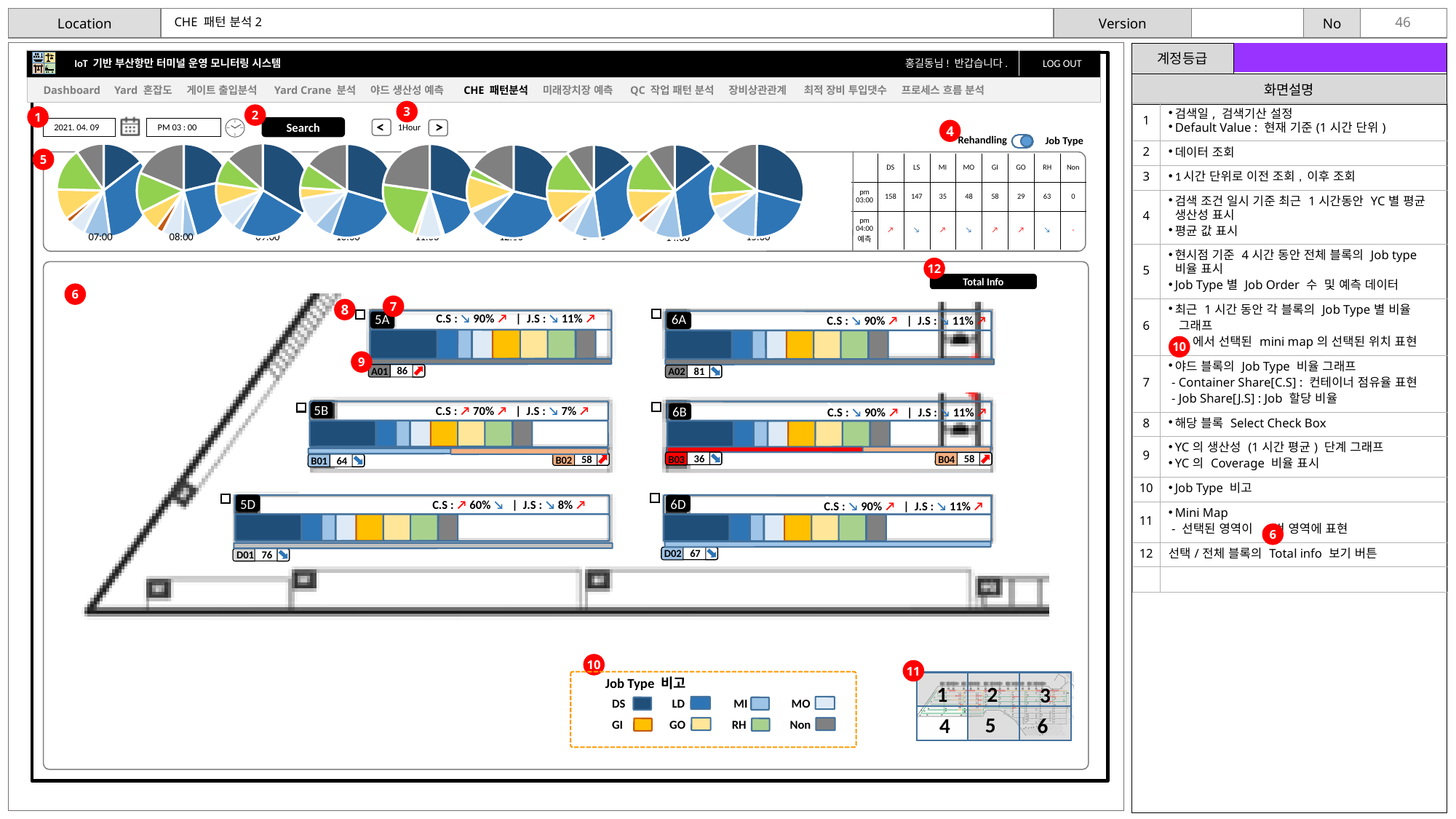
What kind of chart is used in the row of charts at the top of the dashboard (labelled 07:00 to 15:00)? pie chart How many job types does the 'Job Type 비고' legend list? 8 Which block has the larger C.S value, 5A or 5B? 5A In the table next to the pie charts, what is the difference between the DS and LS values at pm 03:00? 11 In the table next to the pie charts, which job type has the highest value at pm 03:00? DS In the table next to the pie charts, what is the value for DS at pm 03:00? 158 In the table next to the pie charts, which job type has the lowest value at pm 03:00? Non How many pie charts are shown in the top row of the dashboard? 9 What is the J.S value shown for block 5D? 8% In the 'Job Type 비고' legend, which job type is shown in green? RH What is the C.S value shown for block 5B? 70% What kind of chart is used inside each block panel (5A, 6A, 5B, 6B, 5D, 6D) to show the job type mix? bar chart